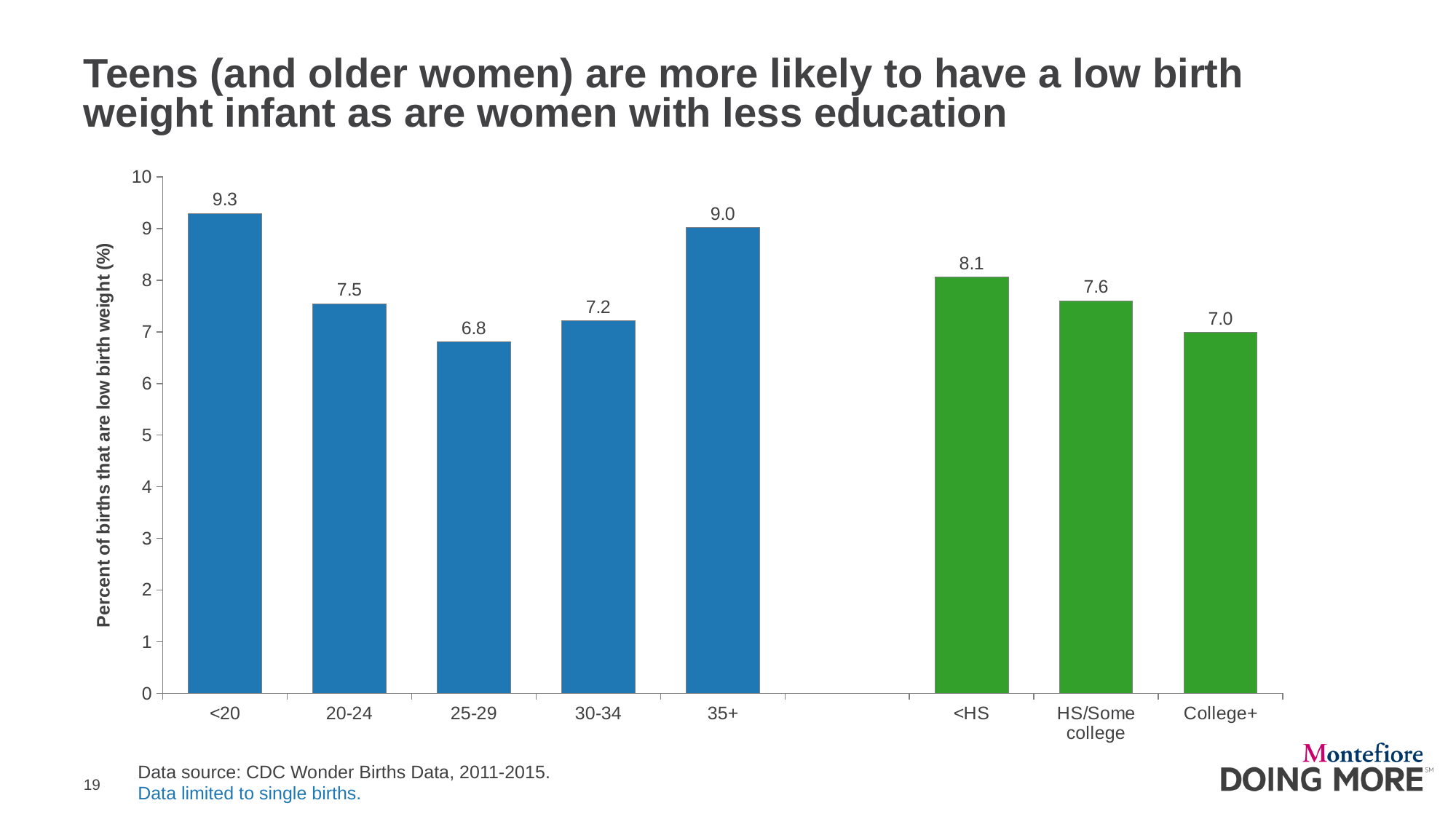
Is the value for 30-34 greater or less than 8? less What is the difference between the values for <HS and College+? 1.1 What kind of chart is shown on the slide? Bar chart What is the difference between the values for <20 and 25-29? 2.5 What is the percent of low birth weight births for mothers with College+ education? 7.0 Which has a higher percent of low birth weight births, 35+ or <HS? 35+ What is the percent of low birth weight births for mothers aged <20? 9.3 Which category has the highest percent of low birth weight births? <20 Which category has the lowest percent of low birth weight births? 25-29 What is the value shown for the HS/Some college category? 7.6 What is the label of the y axis? Percent of births that are low birth weight (%) How many categories are shown on the x axis? 8